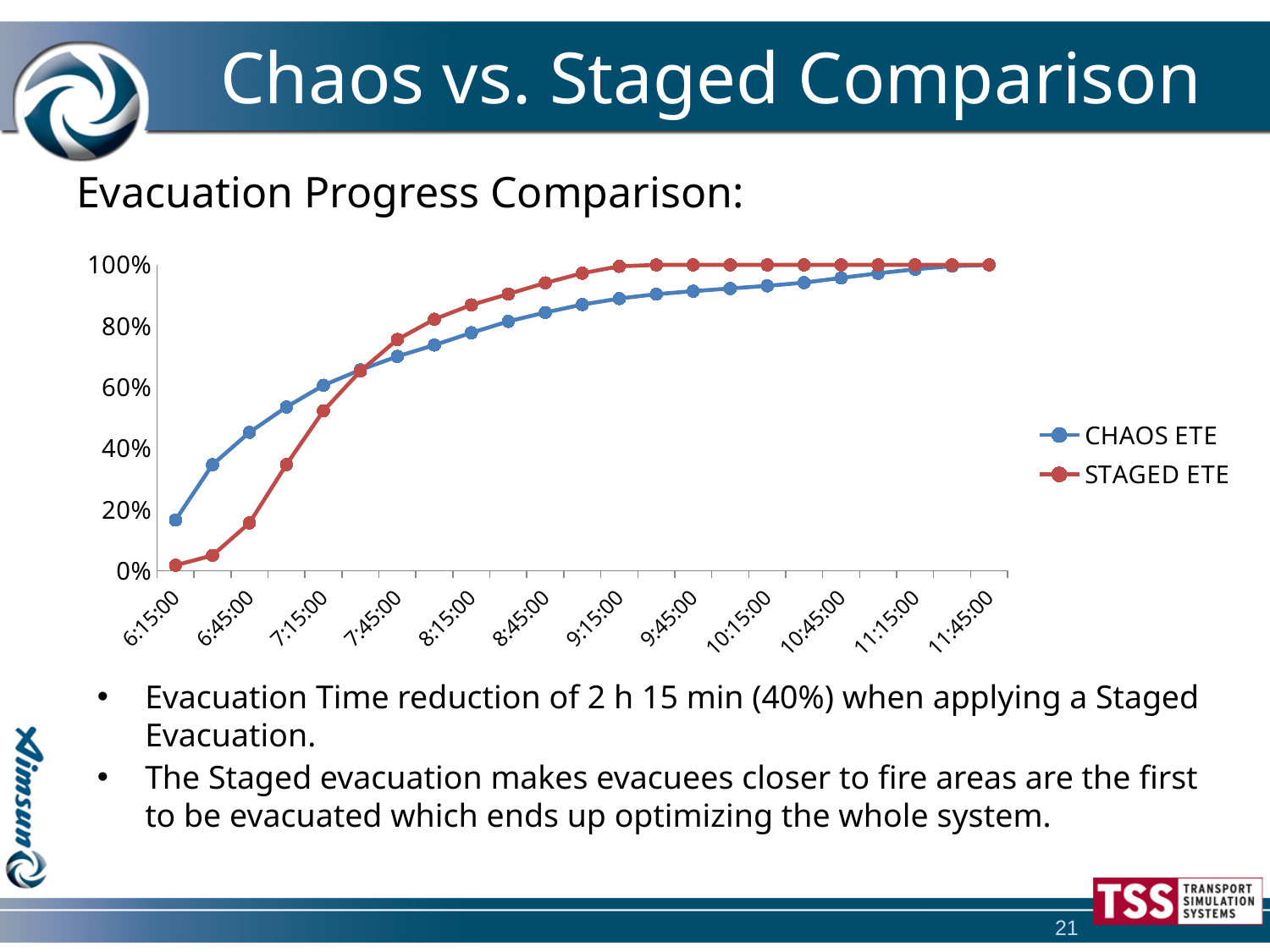
Which series is drawn in red? STAGED ETE What are the two series named in the legend? CHAOS ETE and STAGED ETE Is the value for STAGED ETE at 6:45:00 greater or less than 20%? less At 6:45:00, which series has the larger value, CHAOS ETE or STAGED ETE? CHAOS ETE How many series does the legend list? 2 What kind of chart is shown on the slide? line chart Is the value for STAGED ETE at 8:15:00 greater or less than 80%? greater At 8:15:00, which series has the larger value, CHAOS ETE or STAGED ETE? STAGED ETE Is the value for CHAOS ETE at 6:45:00 greater or less than 40%? greater Do the values of the STAGED ETE series rise or fall along the x axis? rise Which series reaches 100% first along the x axis? STAGED ETE